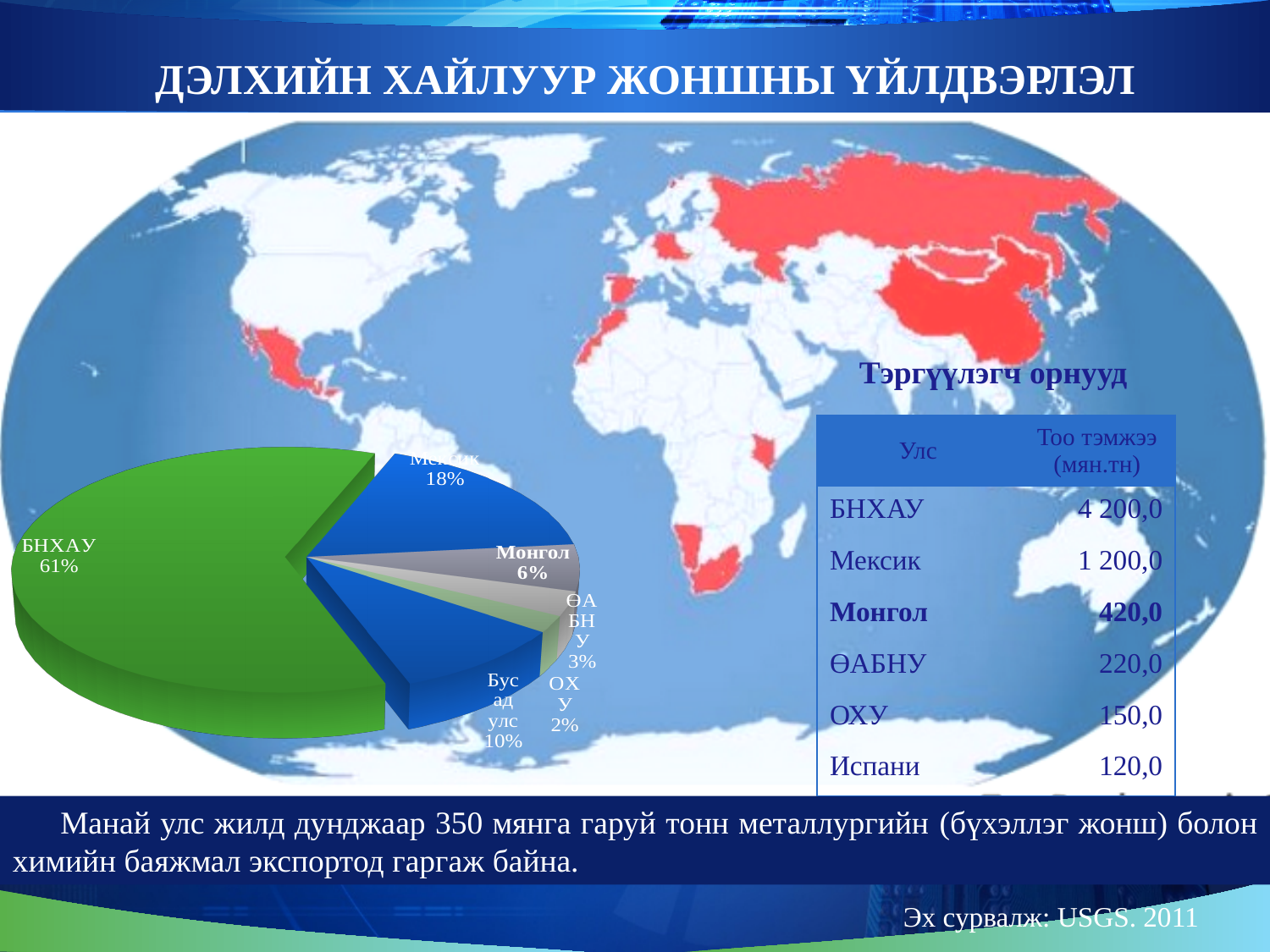
What share of the pie chart does БНХАУ hold? 61% What percentage is shown for Мексик in the pie chart? 18% What kind of chart is shown on the slide? pie chart Which slice of the pie chart is the largest? БНХАУ What percentage is shown for ӨАБНУ in the pie chart? 3% Which slice of the pie chart is the smallest? ОХУ What percentage is shown for Монгол in the pie chart? 6% What percentage is shown for ОХУ in the pie chart? 2% Which is larger in the pie chart, Мексик or Бусад улс? Мексик What percentage is shown for Бусад улс in the pie chart? 10% How many slices does the pie chart have? 6 What is the difference in percentage points between БНХАУ and Мексик in the pie chart? 43